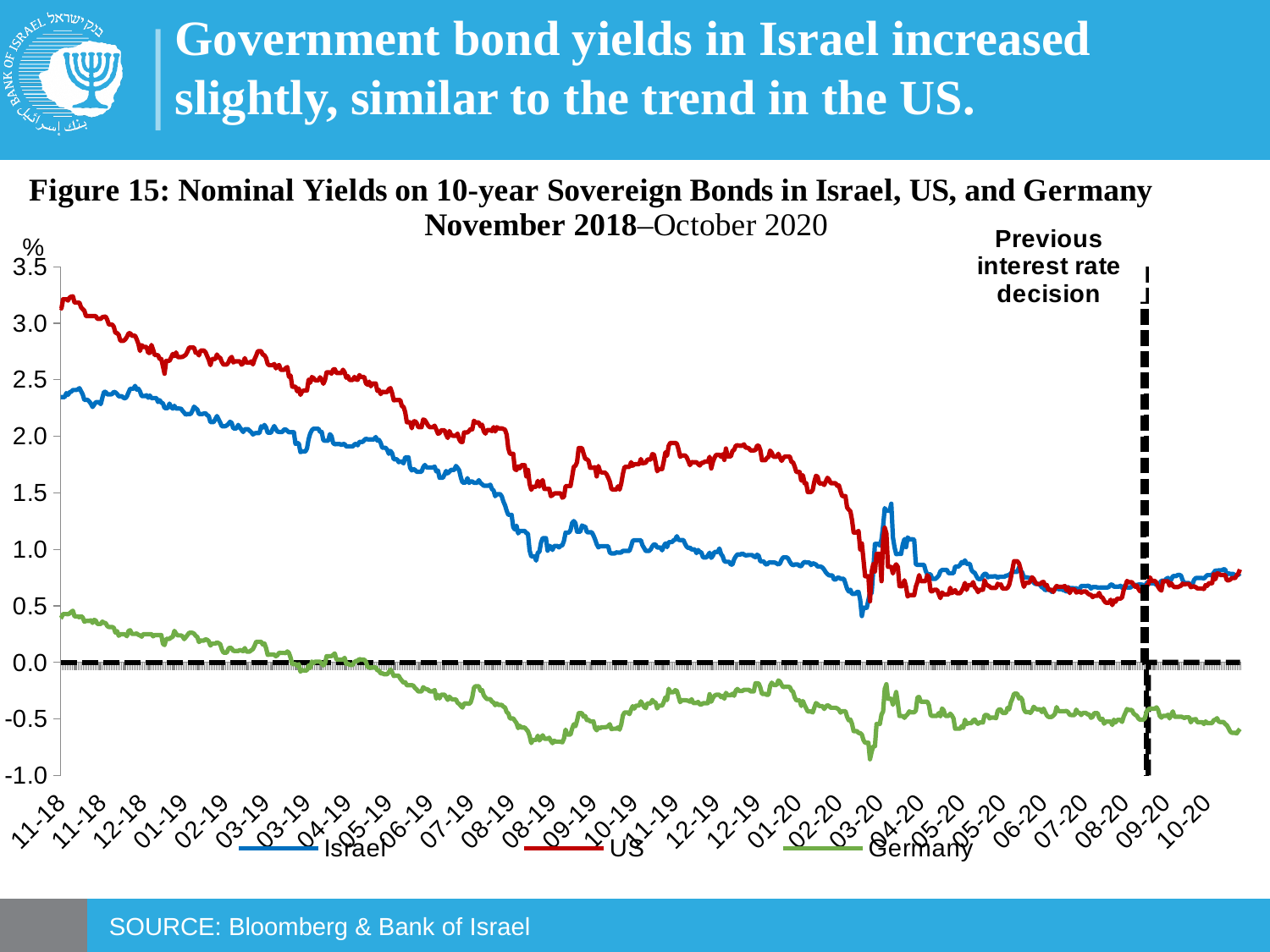
Is the US yield at the start of the period (11-18) greater or less than 3.0? greater Does the US yield rise or fall overall from November 2018 to October 2020? fall Is the Israel yield at the end of the period (10-20) greater or less than 1.0? less Is the Germany yield at the start of the period (11-18) greater or less than 0.5? less What kind of chart is shown on the slide? line chart Which three countries are shown in the legend? Israel, US, Germany At the start of the period (11-18), which is higher, the US yield or the Israel yield? US Which series has the lowest yield throughout the period? Germany How many series does the legend list? 3 What is the unit shown on the y axis? %